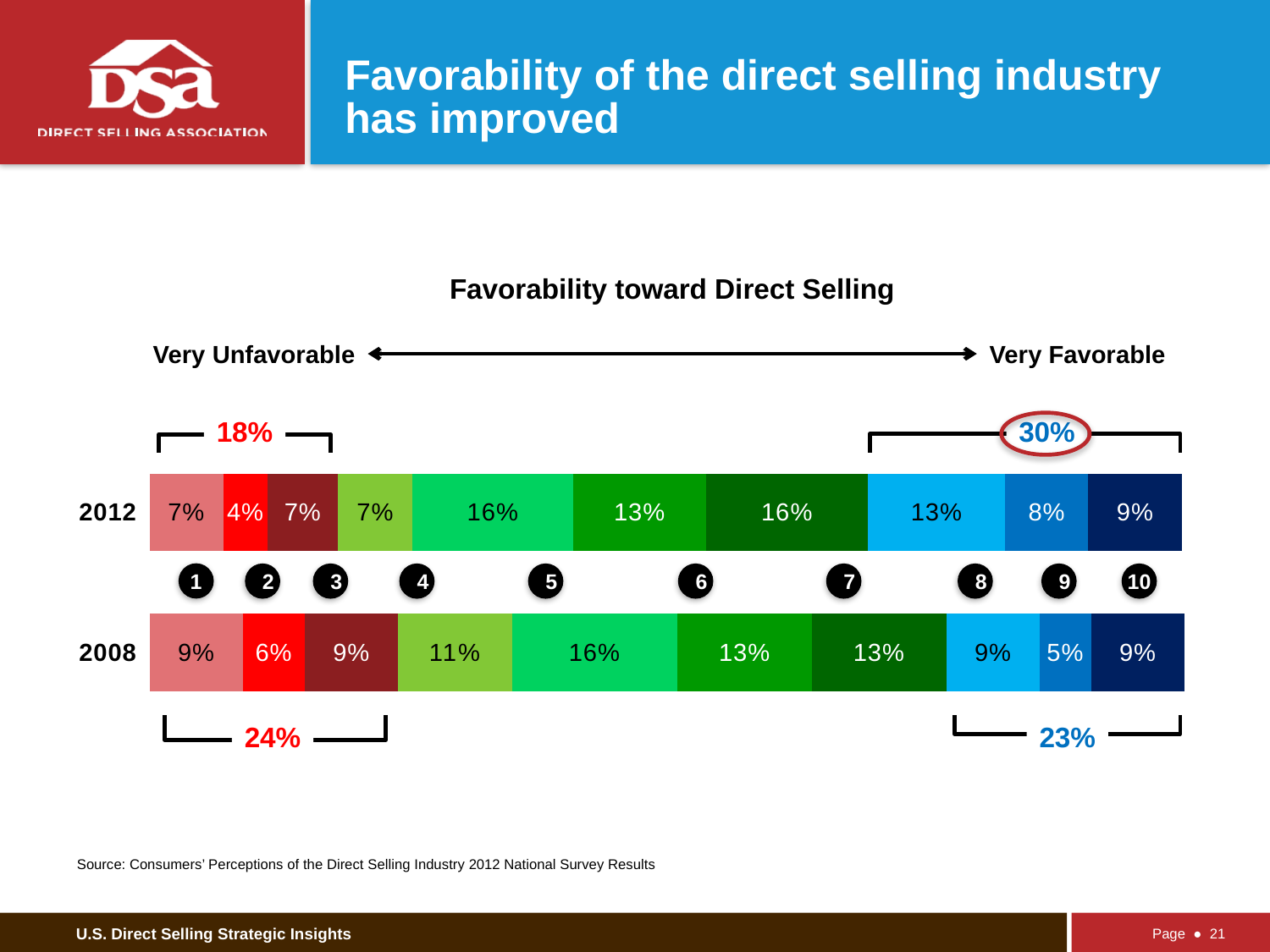
What percentage of respondents gave a rating of 5 in 2012? 16% What percentage of respondents gave a rating of 4 in 2008? 11% What is the difference between the share of rating 4 in 2008 and in 2012? 4% How many rating categories are shown in each bar? 10 What percentage of respondents gave a rating of 2 in 2008? 6% What is the combined share of ratings 1 to 3 in 2008, as shown by the bracket label? 24% What kind of chart is shown on the slide? Stacked bar chart What is the combined share of ratings 8 to 10 in 2012, as shown by the bracket label? 30% Which year has the larger share of ratings 8 to 10, 2012 or 2008? 2012 What percentage of respondents gave a rating of 9 in 2012? 8% Which rating has the lowest share in the 2012 bar? 2 What is the title of the chart? Favorability toward Direct Selling